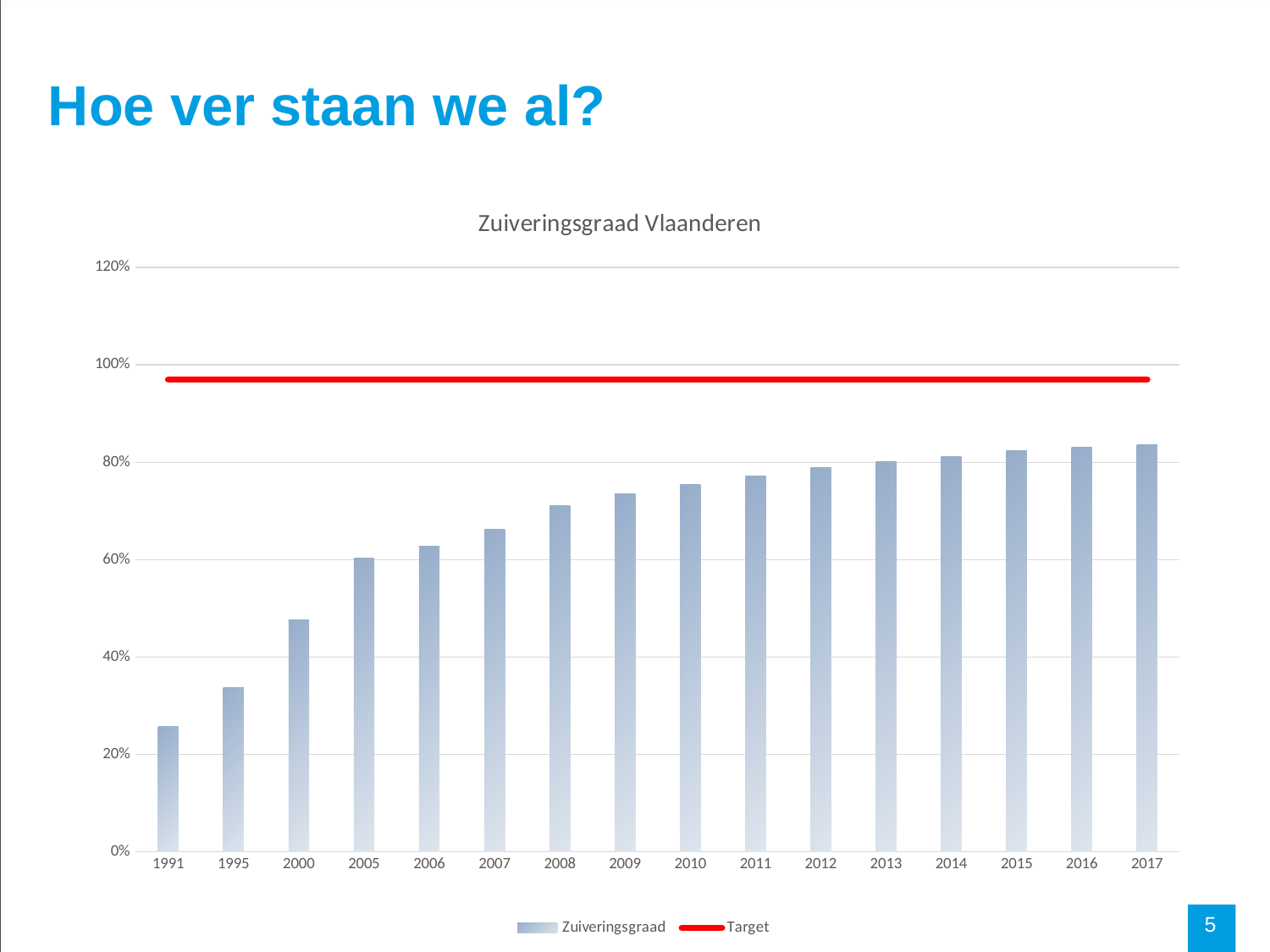
Which is larger, the Zuiveringsgraad for 2000 or for 2010? 2010 Which year has the lowest Zuiveringsgraad? 1991 Do the Zuiveringsgraad values rise or fall from 1991 to 2017? rise Is the Zuiveringsgraad for 2017 greater or less than 80%? greater Which year has the highest Zuiveringsgraad? 2017 Is the Zuiveringsgraad for 2000 greater or less than 40%? greater How many series does the legend list? 2 What is the title of the chart? Zuiveringsgraad Vlaanderen Is the Zuiveringsgraad for 2008 greater or less than 80%? less What kind of chart is shown on the slide? combination bar and line chart How many years are shown on the x axis? 16